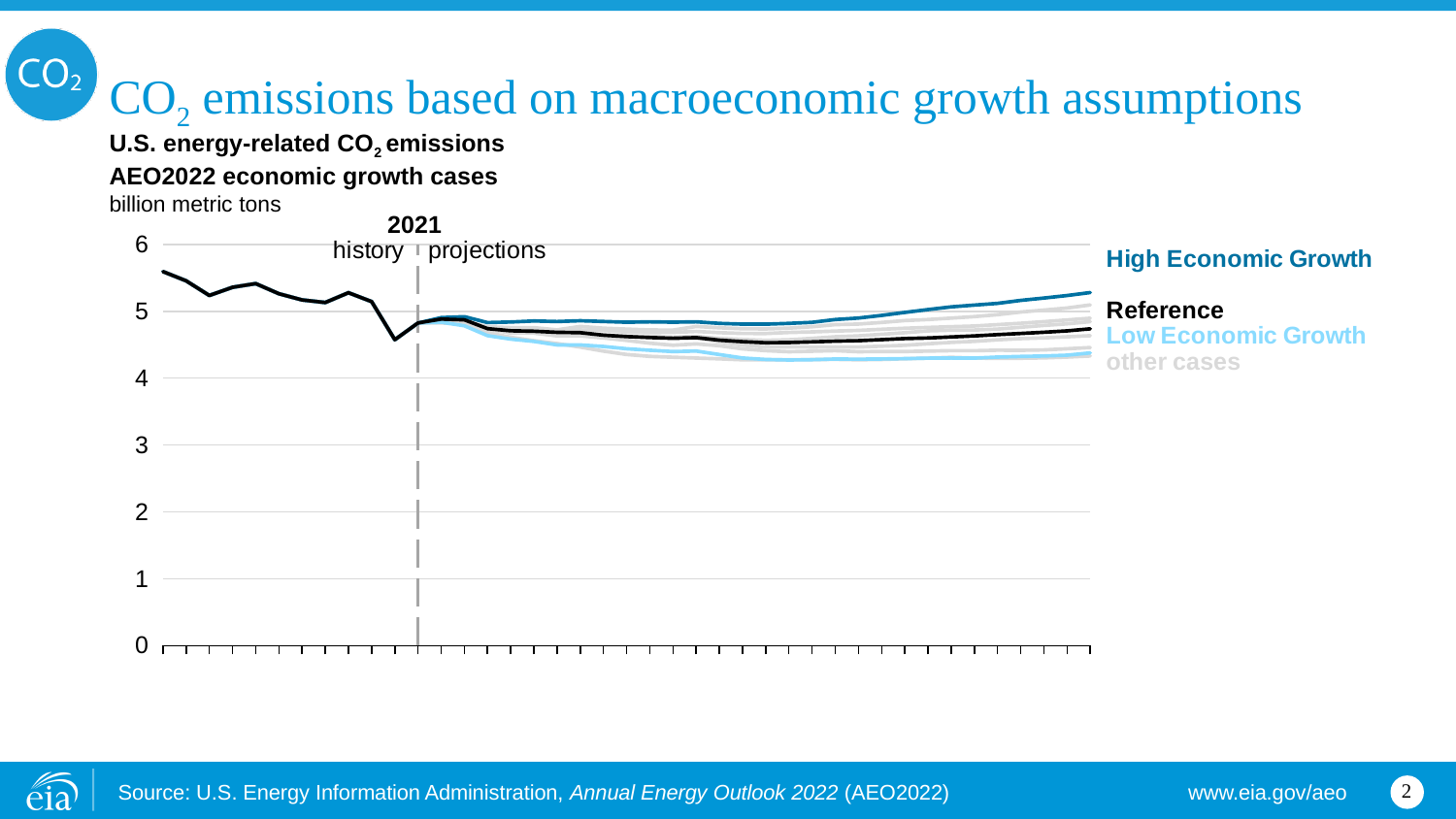
At the end of the projection period, is the value for Low Economic Growth greater or less than 5? less Which case has the highest value at the end of the projection period? High Economic Growth At the end of the projection period, which case has the higher value: High Economic Growth or Low Economic Growth? High Economic Growth Which year separates history from projections in the chart? 2021 Over the projection period, does the High Economic Growth line rise or fall overall? rise What unit is used for the y axis of the chart? billion metric tons At the end of the projection period, is the value for High Economic Growth greater or less than 5? greater What kind of chart is shown on the slide? line chart How many labelled entries does the chart's legend list? 4 At the start of the history period, is the emissions value greater or less than 5? greater